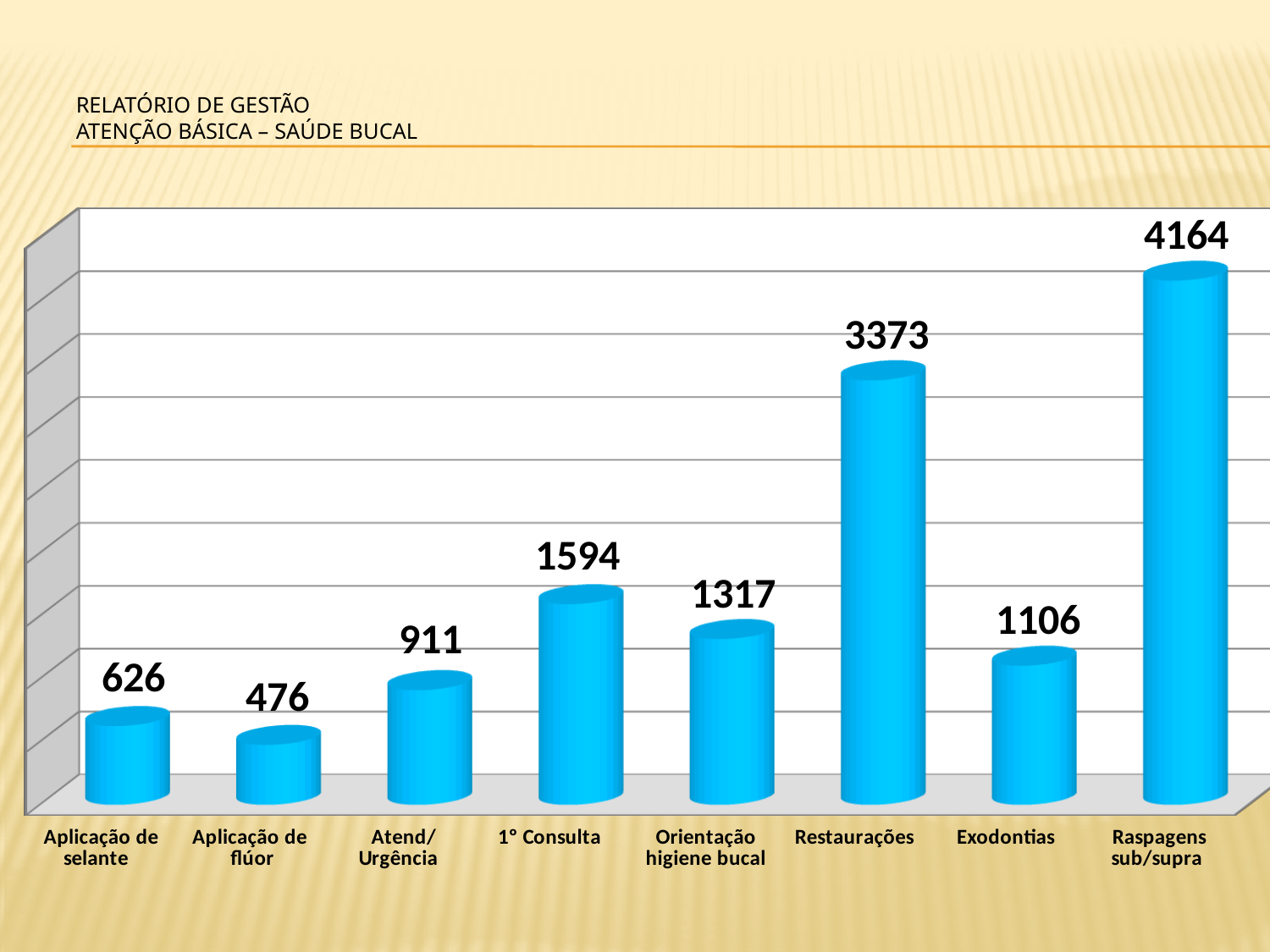
What kind of chart is shown on the slide? Bar chart What is the value for Orientação higiene bucal? 1317 Which category has the highest value? Raspagens sub/supra Which category has the lowest value? Aplicação de flúor What is the value for Exodontias? 1106 What is the difference between the values for Raspagens sub/supra and Restaurações? 791 What colour are the bars in the chart? Blue What is the value for Restaurações? 3373 Which is larger, the value for Aplicação de selante or the value for Aplicação de flúor? Aplicação de selante What is the value for Aplicação de flúor? 476 What is the difference between the values for 1° Consulta and Atend/Urgência? 683 How many categories are shown in the chart? 8